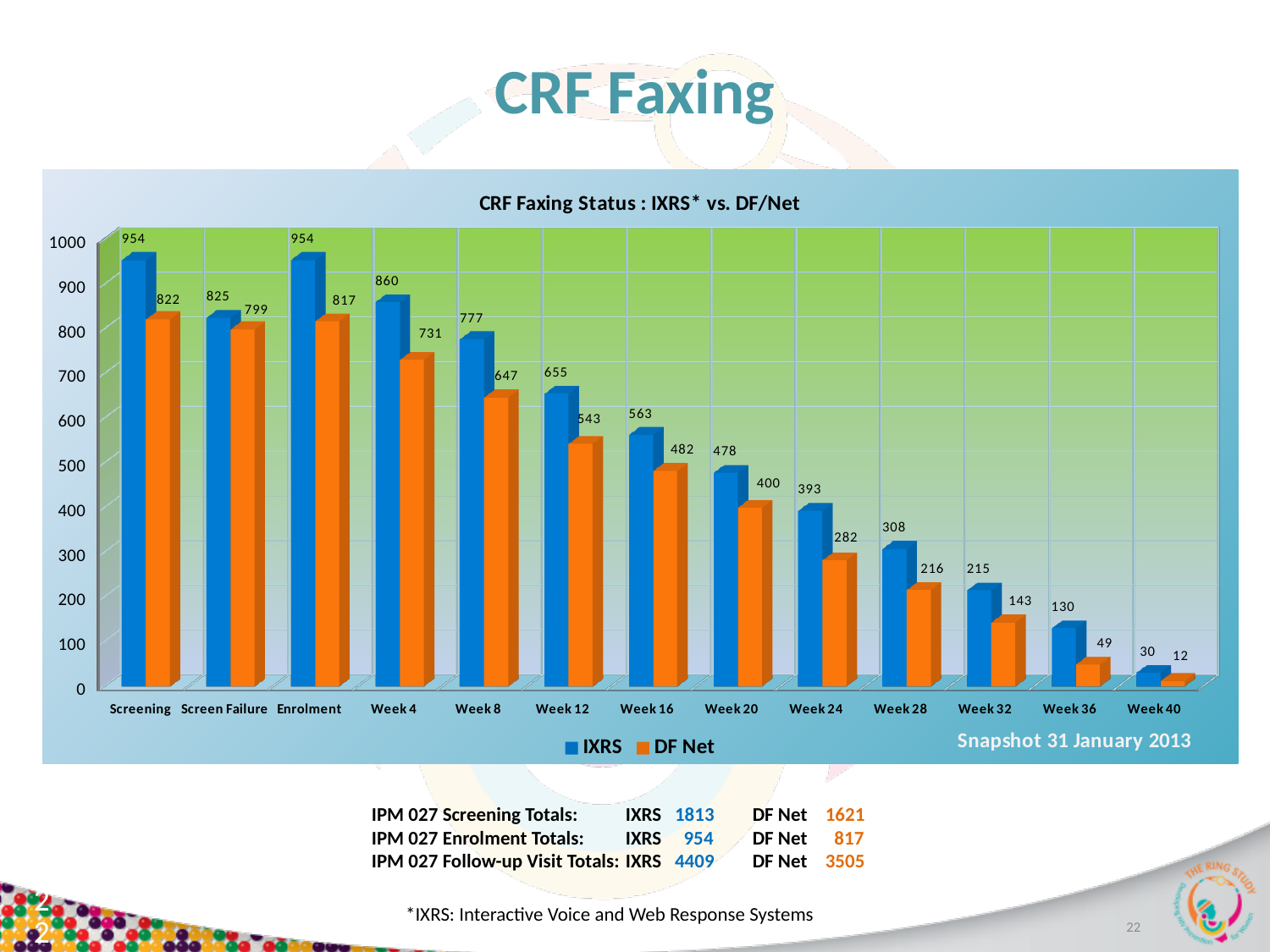
What is the IXRS value for Week 12? 655 What is the DF Net value for Week 24? 282 Is the IXRS value for Week 28 greater or less than 300? greater What is the DF Net value for Screen Failure? 799 How many categories are shown on the x axis? 13 Which is larger for Week 20: the IXRS value or the DF Net value? IXRS Which category has the lowest DF Net value? Week 40 What is the difference between the IXRS and DF Net values for Week 4? 129 How many series does the legend list? 2 What kind of chart is shown? Bar chart What is the difference between the IXRS and DF Net values for Week 36? 81 Do the IXRS values rise or fall from Week 4 to Week 40? Fall